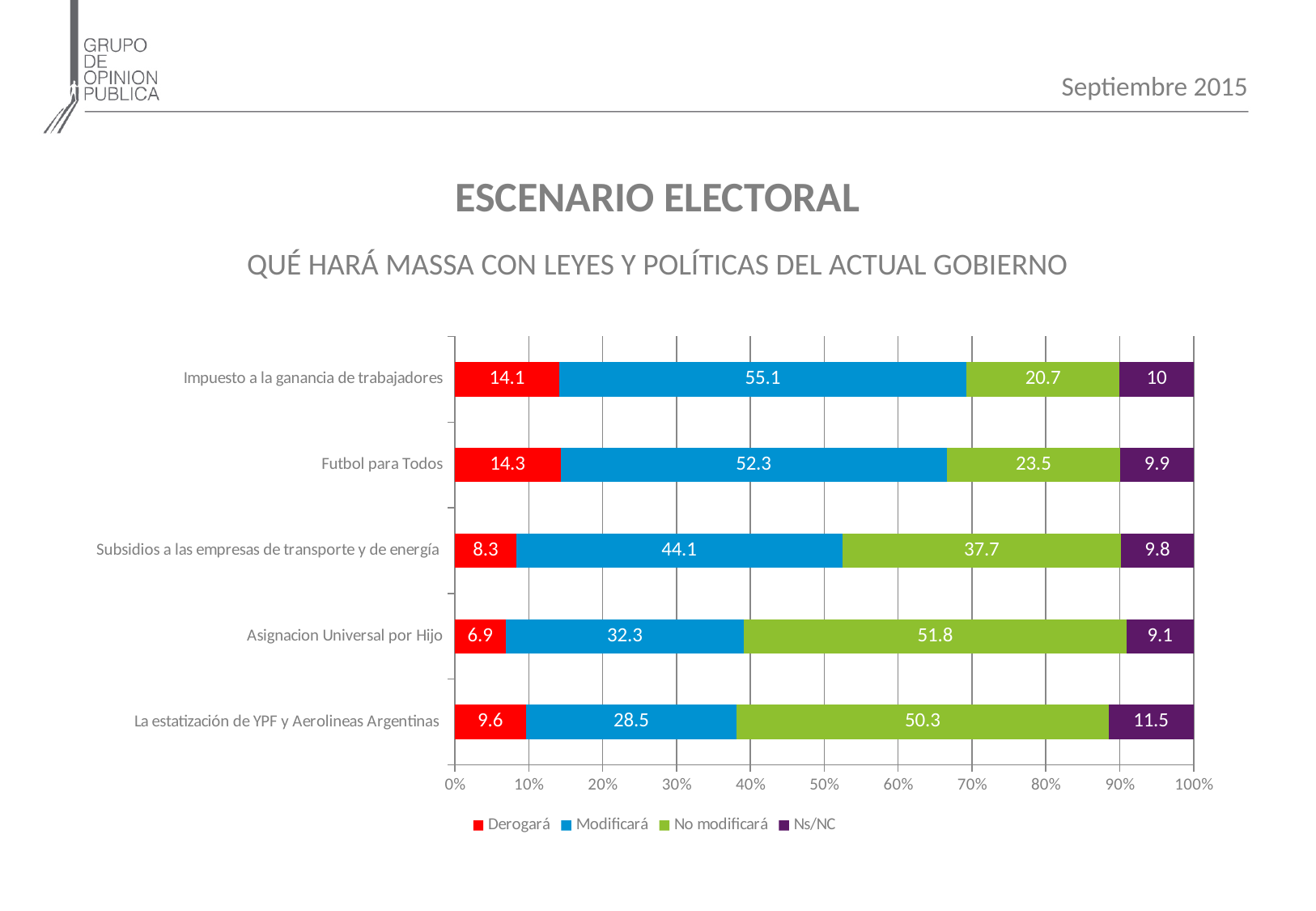
What kind of chart is shown on the slide? Stacked bar chart Which is larger: the 'Derogará' value for Futbol para Todos or for Subsidios a las empresas de transporte y de energía? Futbol para Todos What is the difference between the 'No modificará' values for Asignacion Universal por Hijo and La estatización de YPF y Aerolineas Argentinas? 1.5 What is the 'No modificará' value for Asignacion Universal por Hijo? 51.8 How many series does the legend list? 4 Which colour represents 'No modificará' in the legend? Green What is the Ns/NC value for La estatización de YPF y Aerolineas Argentinas? 11.5 What is the total of the stacked bar for Futbol para Todos? 100 Which category has the highest 'Modificará' value? Impuesto a la ganancia de trabajadores Which category has the lowest 'Derogará' value? Asignacion Universal por Hijo How many categories (policies) are shown on the chart? 5 What percentage of respondents said Massa 'Modificará' the Impuesto a la ganancia de trabajadores? 55.1